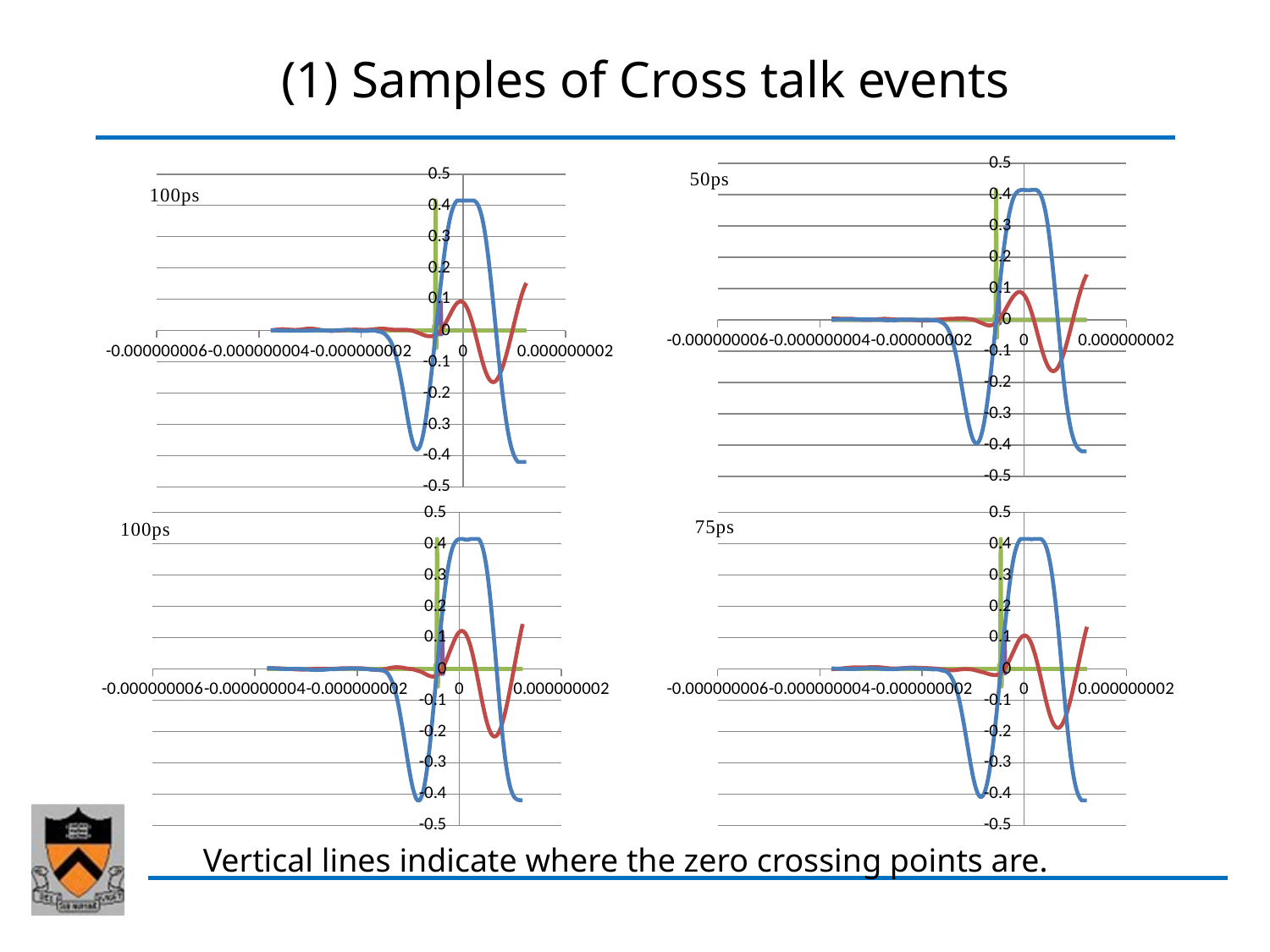
In the top-right chart labelled 50ps, what is the highest value shown on the vertical axis? 0.5 What is the label on the bottom-right chart? 75ps How many charts are shown on the slide? 4 In the bottom-right chart labelled 75ps, which curve reaches a higher peak, the blue curve or the red curve? the blue curve What kind of chart is the top-left chart labelled 100ps? line chart In the top-left chart labelled 100ps, is the peak value of the blue curve greater or less than 0.3? greater In the top-right chart labelled 50ps, is the peak value of the red curve greater or less than 0.2? less What is the label on the top-right chart? 50ps In the bottom-left chart labelled 100ps, what is the lowest value shown on the vertical axis? -0.5 In the top-left chart labelled 100ps, what is the rightmost tick label on the horizontal axis? 0.000000002 In the bottom-right chart labelled 75ps, what is the leftmost tick label on the horizontal axis? -0.000000006 How many of the charts on the slide are labelled 100ps? 2